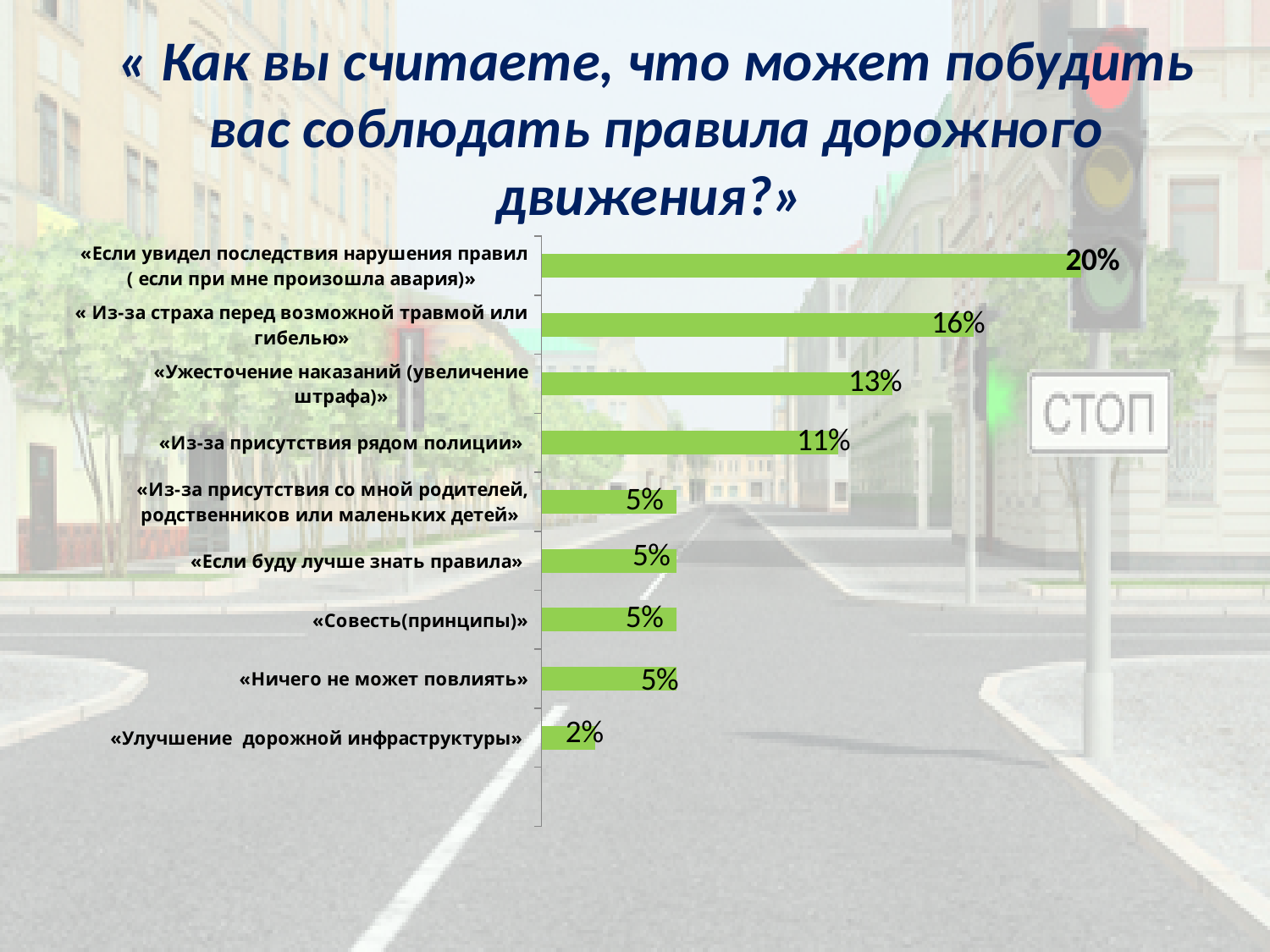
What is the value for «Из-за страха перед возможной травмой или гибелью»? 16% What is the difference between the values for «Если увидел последствия нарушения правил» and «Из-за страха перед возможной травмой или гибелью»? 4% What is the value for «Если увидел последствия нарушения правил (если при мне произошла авария)»? 20% How many categories (answer options) does the chart show? 9 Which is larger: the value for «Ужесточение наказаний (увеличение штрафа)» or for «Из-за присутствия рядом полиции»? «Ужесточение наказаний (увеличение штрафа)» Which category has the lowest value? «Улучшение дорожной инфраструктуры» What is the value for «Улучшение дорожной инфраструктуры»? 2% What kind of chart is shown on the slide? Bar chart What is the value for «Ужесточение наказаний (увеличение штрафа)»? 13% What colour are the bars in the chart? Green Which category has the highest value? «Если увидел последствия нарушения правил (если при мне произошла авария)» What is the value for «Из-за присутствия рядом полиции»? 11%